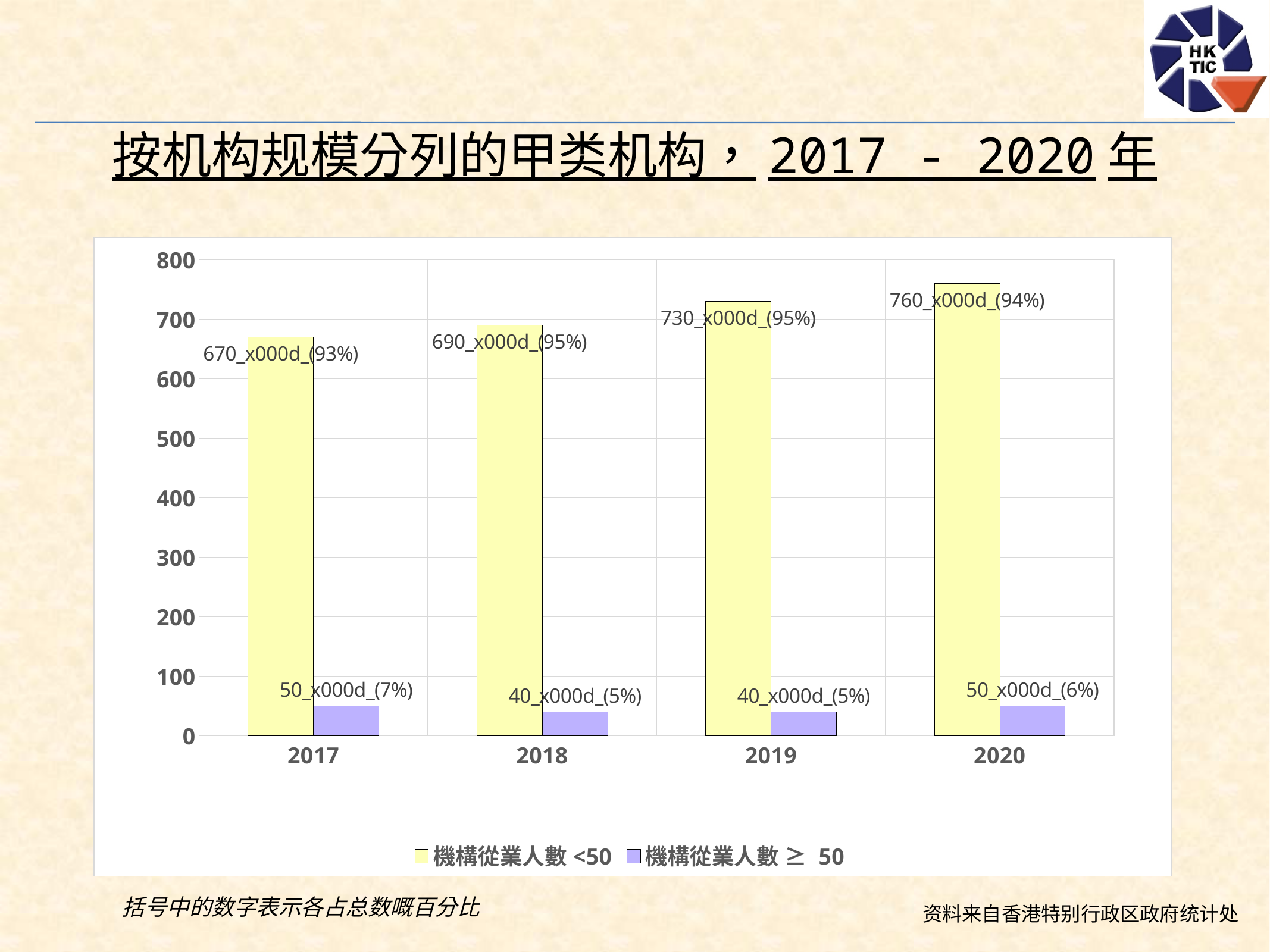
How many years are shown on the x axis? 4 What is the value for 機構從業人數 <50 in 2020? 760 What is the value for 機構從業人數 ≥ 50 in 2018? 40 What is the difference between the 機構從業人數 <50 values for 2020 and 2017? 90 Which year has the highest value for 機構從業人數 <50? 2020 Do the values for 機構從業人數 <50 rise or fall from 2017 to 2020? rise Which series is shown in yellow? 機構從業人數 <50 What is the value for 機構從業人數 <50 in 2017? 670 What kind of chart is shown on the slide? bar chart What percentage share is shown in parentheses for 機構從業人數 <50 in 2019? 95% How many series does the legend list? 2 Which year has the lowest value for 機構從業人數 <50? 2017